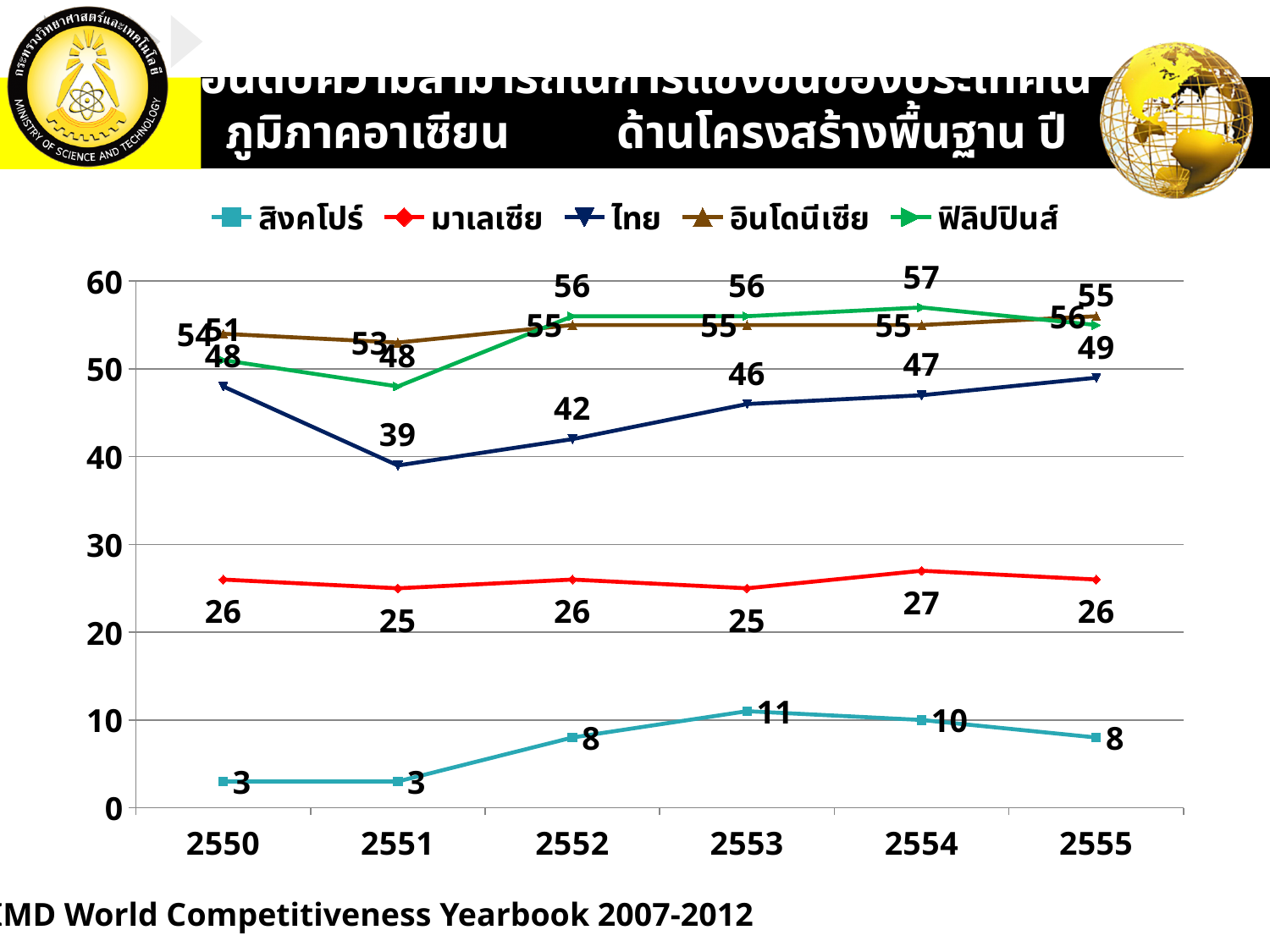
What is the value for ฟิลิปปินส์ in 2554? 57 What kind of chart is shown on the slide? line chart In which year does สิงคโปร์ reach its highest value? 2553 In 2552, which is larger: the value for ไทย or the value for มาเลเซีย? ไทย How many years are shown on the x axis? 6 In which year does ไทย have its lowest value? 2551 What is the value for มาเลเซีย in 2554? 27 What is the value for สิงคโปร์ in 2553? 11 What is the value for ไทย in 2551? 39 What is the difference between the value for ไทย in 2555 and in 2551? 10 Is the value for มาเลเซีย in 2550 greater or less than 30? less How many series does the legend list? 5